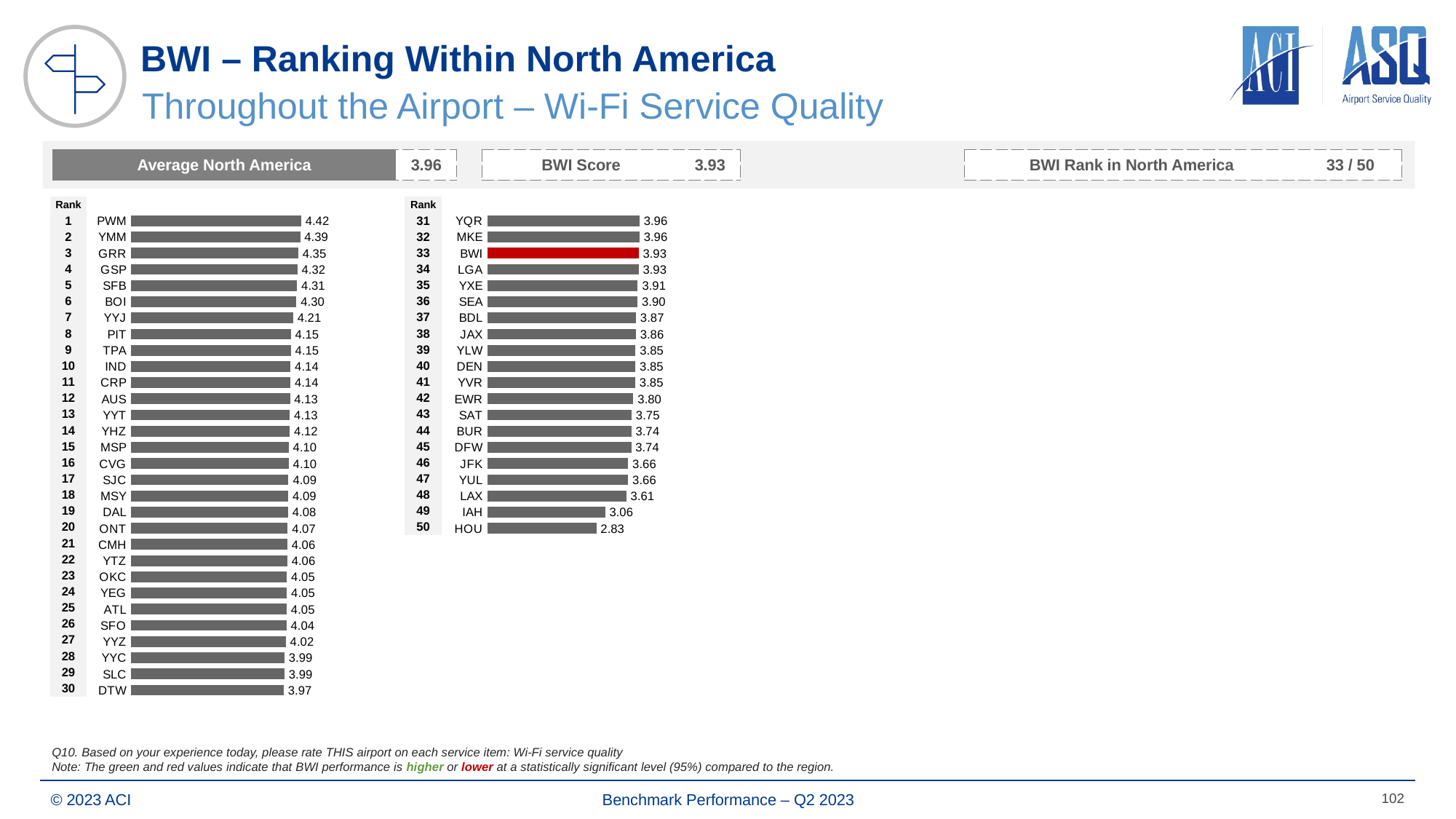
What is BWI's score in the ranking chart? 3.93 How many airports are ranked in the chart? 50 What is the score for SEA, ranked 36th? 3.90 What is BWI's rank in North America as shown on the slide? 33 / 50 What is the difference between PWM's score and HOU's score? 1.59 What kind of chart is used to show the airport rankings? Bar chart Which airport's bar is highlighted in red in the ranking chart? BWI What is the difference between the Average North America score and the BWI Score? 0.03 What is the Wi-Fi service quality score for PWM, ranked 1st? 4.42 Which has a higher score, IAH or LAX? LAX Which airport has the lowest score in the ranking chart? HOU Which airport has the highest score in the ranking chart? PWM